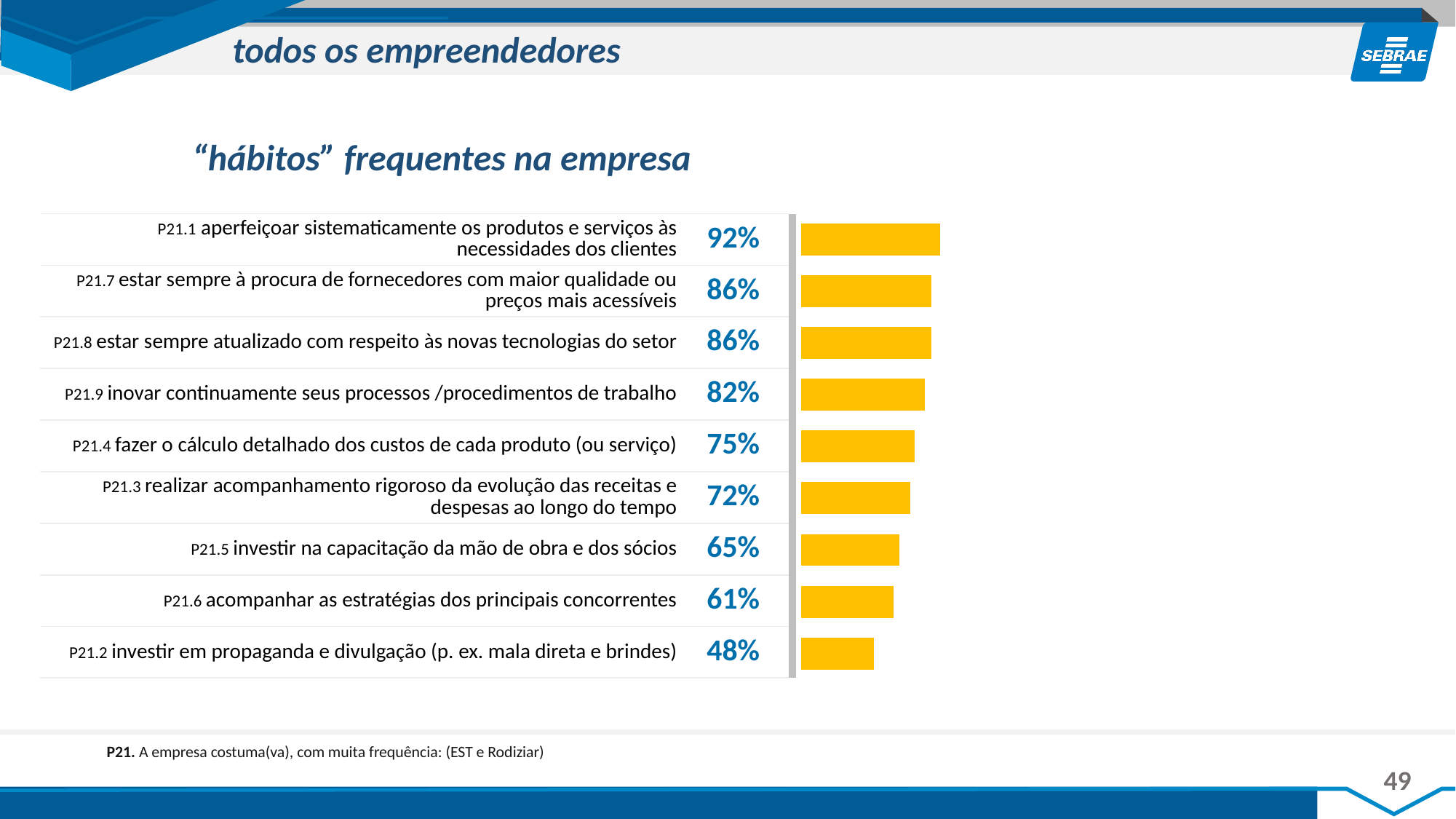
What is the difference between the percentages for P21.1 and P21.2? 44% What colour are the bars in the chart? Yellow What percentage is shown for P21.5 investir na capacitação da mão de obra e dos sócios? 65% What percentage is shown for P21.2 investir em propaganda e divulgação? 48% How many habits are listed in the chart? 9 Which has a larger percentage, P21.6 acompanhar as estratégias dos principais concorrentes or P21.5 investir na capacitação da mão de obra e dos sócios? P21.5 investir na capacitação da mão de obra e dos sócios What is the difference between the percentages for P21.9 and P21.3? 10% Which habit has the lowest percentage? P21.2 investir em propaganda e divulgação (p. ex. mala direta e brindes) What percentage is shown for P21.1 aperfeiçoar sistematicamente os produtos e serviços às necessidades dos clientes? 92% Which habit has the highest percentage? P21.1 aperfeiçoar sistematicamente os produtos e serviços às necessidades dos clientes What kind of chart is shown on the slide? Bar chart What percentage is shown for P21.4 fazer o cálculo detalhado dos custos de cada produto (ou serviço)? 75%